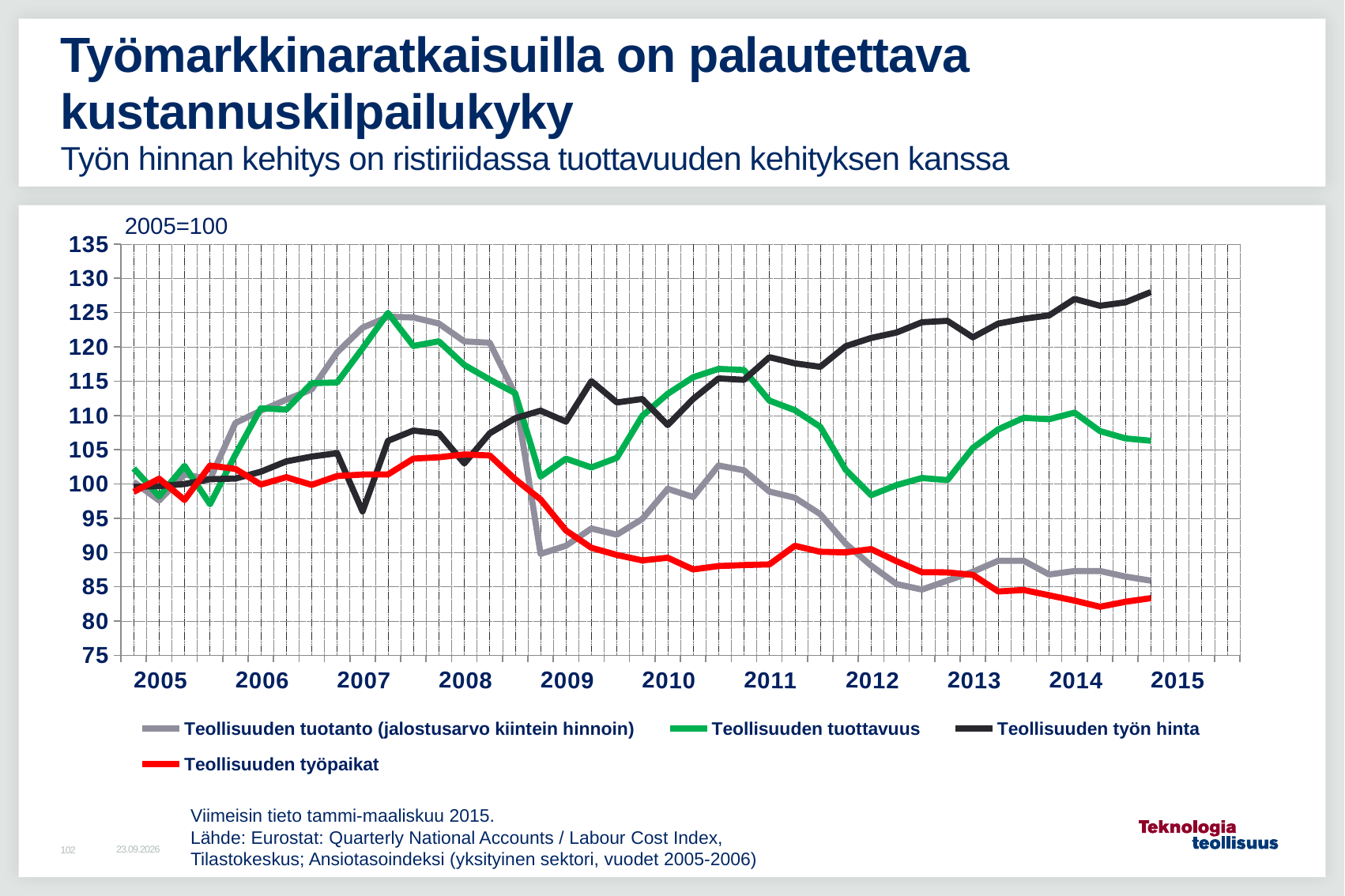
Is the value for Teollisuuden työpaikat at the start of 2015 greater or less than 85? less Is the value for Teollisuuden tuotanto at the start of 2009 greater or less than 95? less What base year and index value is stated above the chart? 2005=100 Is the peak value of Teollisuuden tuotanto in 2007 greater or less than 120? greater How many series does the legend list? 4 Which series has the highest value at the start of 2015? Teollisuuden työn hinta Which series has the lowest value at the start of 2015? Teollisuuden työpaikat What kind of chart is shown on the slide? line chart Which series is plotted with the red line? Teollisuuden työpaikat Does the Teollisuuden työn hinta line generally rise or fall from 2005 to 2015? rise At the start of 2015, which is higher: Teollisuuden tuottavuus or Teollisuuden tuotanto? Teollisuuden tuottavuus